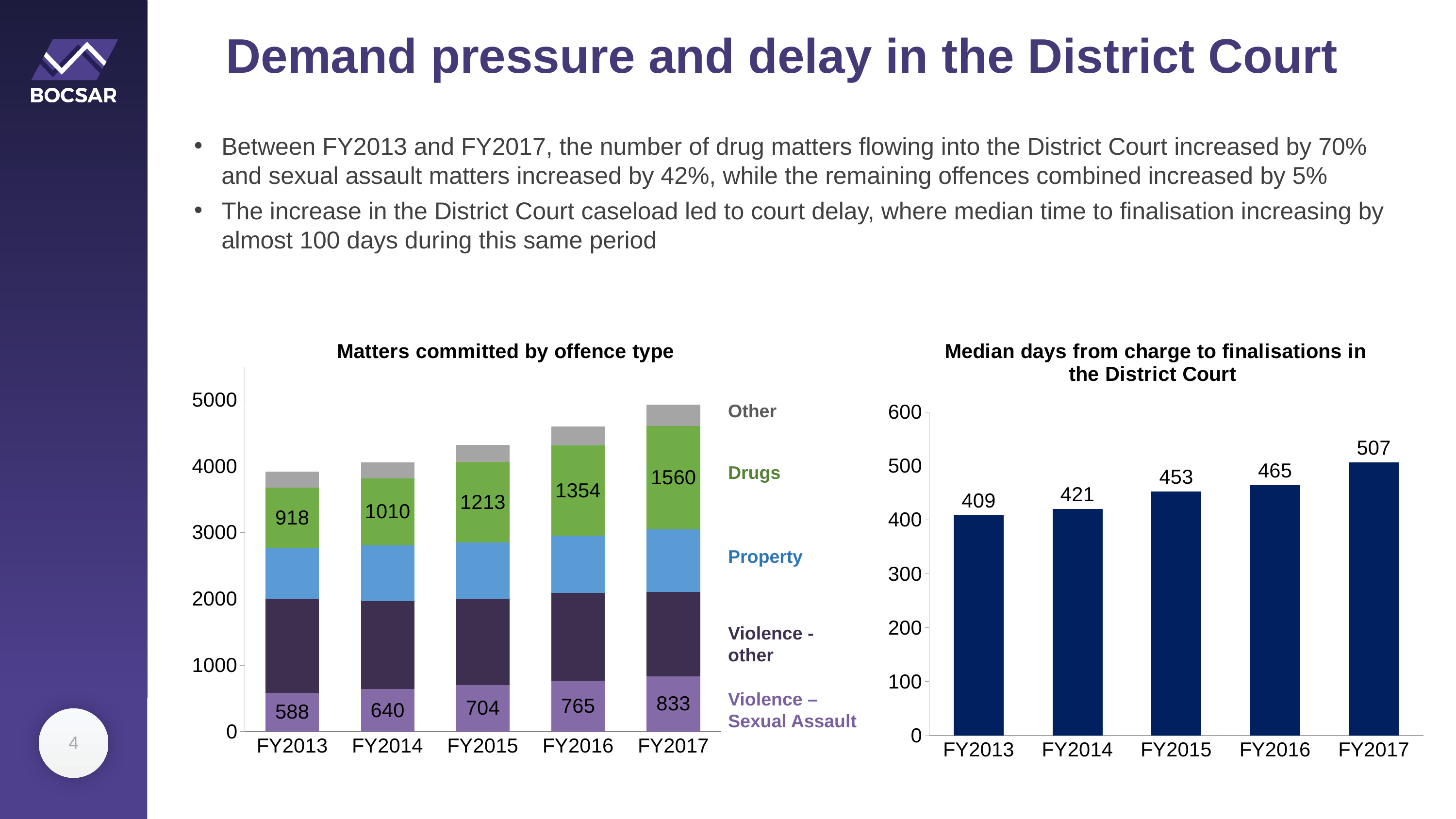
In the 'Matters committed by offence type' chart, what colour represents Drugs? Green In the 'Median days from charge to finalisations in the District Court' chart, what is the difference between FY2017 and FY2013? 98 What type of chart is 'Median days from charge to finalisations in the District Court'? Bar chart In the 'Matters committed by offence type' chart, by how much did the Drugs value increase from FY2013 to FY2017? 642 In the 'Median days from charge to finalisations in the District Court' chart, what is the value for FY2015? 453 In the 'Matters committed by offence type' chart, what is the value for Drugs in FY2017? 1560 In the 'Matters committed by offence type' chart, is the total height of the FY2017 bar greater or less than 4000? greater In the 'Matters committed by offence type' chart, which year has the highest Violence – Sexual Assault value? FY2017 In the 'Median days from charge to finalisations in the District Court' chart, which year has the lowest value? FY2013 In the 'Median days from charge to finalisations in the District Court' chart, do the values rise or fall from FY2013 to FY2017? Rise In the 'Matters committed by offence type' chart, what is the value for Violence – Sexual Assault in FY2013? 588 In the 'Matters committed by offence type' chart, how many offence types does the legend list? 5